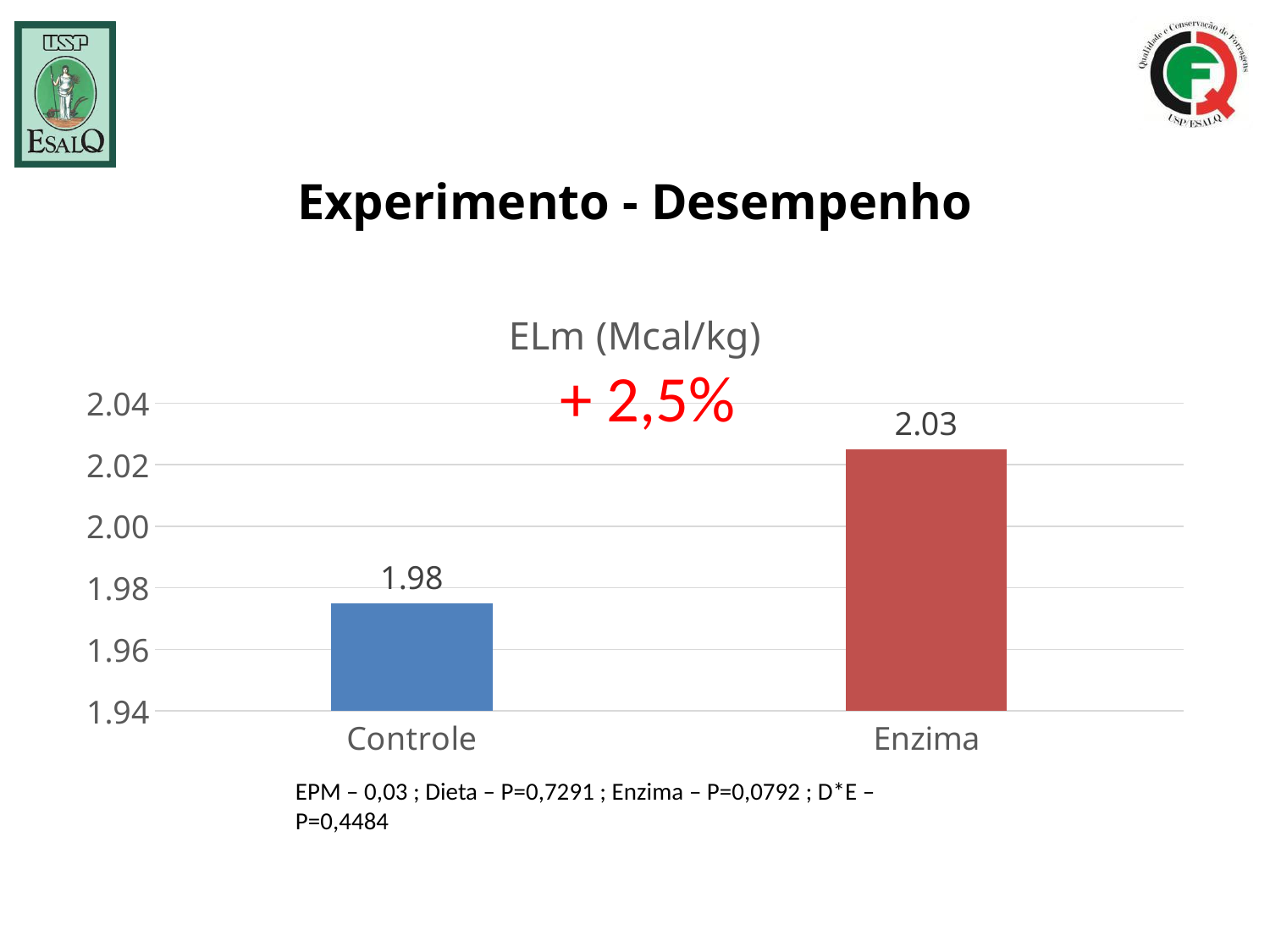
What is the title of the chart? ELm (Mcal/kg) Which is larger, the value for Controle or the value for Enzima? Enzima Is the value for Controle greater or less than 2.00? less What is the value for Controle? 1.98 Is the value for Enzima greater or less than 2.00? greater What percentage change is annotated in red on the chart? + 2,5% How many categories are shown in the chart? 2 Which category has the lowest value? Controle What is the difference between the values for Enzima and Controle? 0.05 What kind of chart is shown on the slide? bar chart Which category has the highest value? Enzima What is the value for Enzima? 2.03